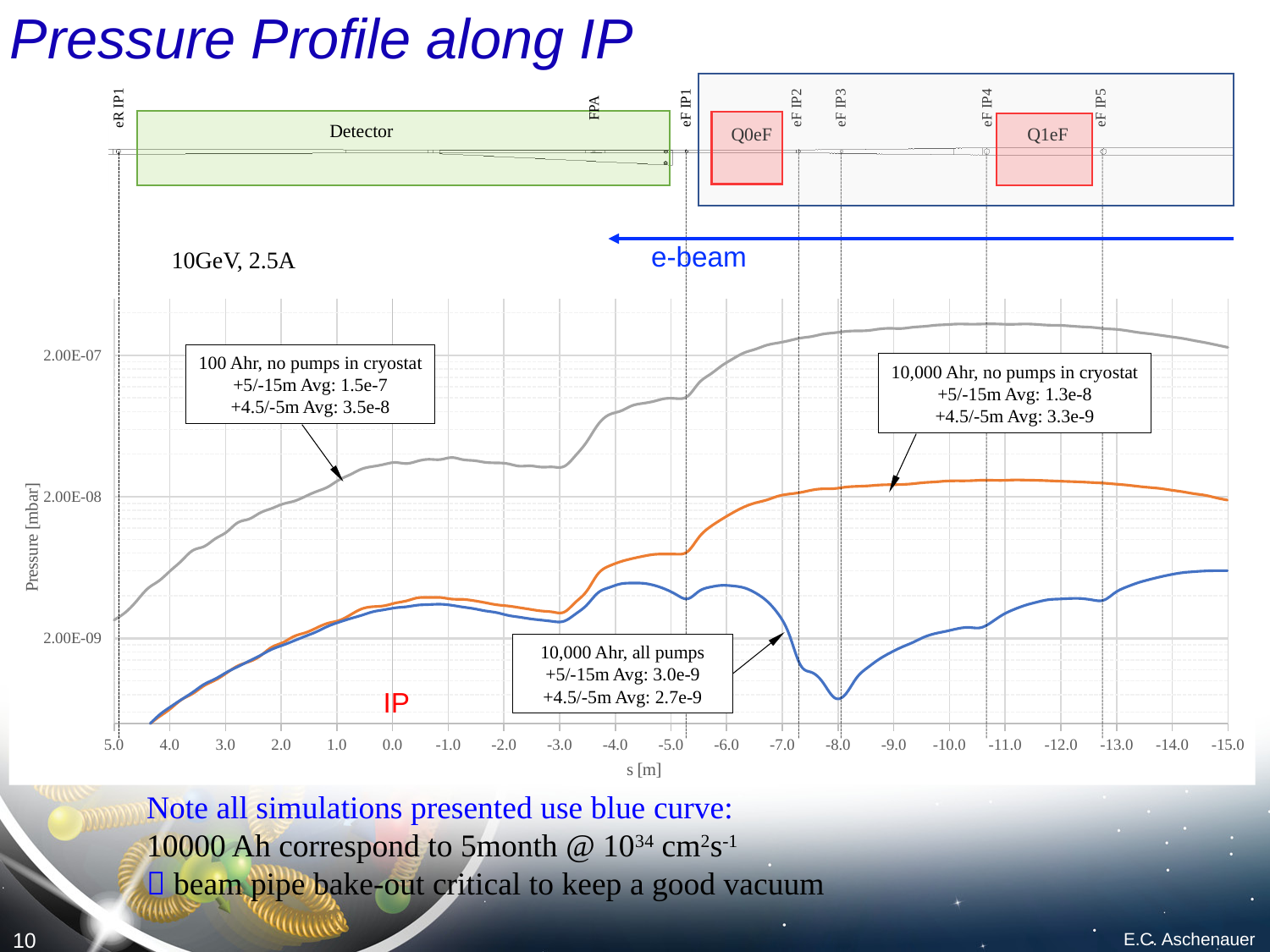
What is the +4.5/-5m average pressure given for the '10,000 Ahr, no pumps in cryostat' curve? 3.3e-9 What is the +5/-15m average pressure given for the '100 Ahr, no pumps in cryostat' curve? 1.5e-7 What is the +5/-15m average pressure given for the '10,000 Ahr, all pumps' curve? 3.0e-9 For the '10,000 Ahr, all pumps' curve, which is larger: the +5/-15m average or the +4.5/-5m average? +5/-15m Avg Is the pressure of the gray '100 Ahr, no pumps in cryostat' curve at s = -10.0 m greater or less than 2.00E-07 mbar? greater How many pressure curves are plotted on the chart? 3 Is the pressure of the blue '10,000 Ahr, all pumps' curve at s = -8.0 m greater or less than 2.00E-09 mbar? less Which curve shows the highest pressure across the profile? 100 Ahr, no pumps in cryostat What is the label of the vertical axis of the chart? Pressure [mbar] What beam energy and current are stated on the chart? 10GeV, 2.5A Does the gray '100 Ahr, no pumps in cryostat' curve rise or fall as s goes from 5.0 m to -10.0 m? rise What type of chart is shown on the slide? line chart